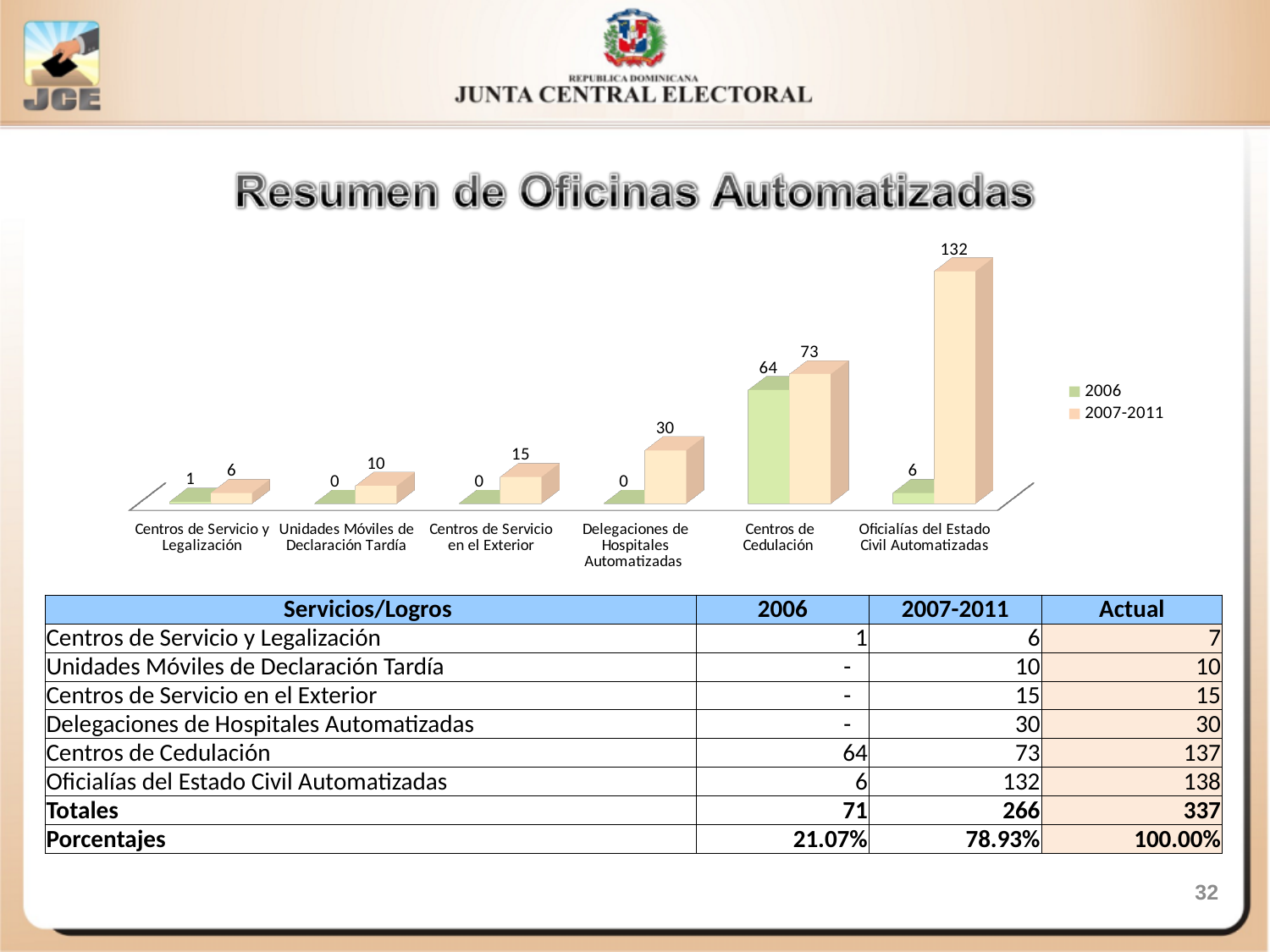
How many categories are shown on the x axis of the chart? 6 What is the difference between the 2007-2011 and 2006 values for Centros de Cedulación? 9 What is the 2006 value for Centros de Cedulación? 64 What kind of chart is shown on the slide? Bar chart What is the title of the chart? Resumen de Oficinas Automatizadas What are the two series named in the chart legend? 2006 and 2007-2011 What is the 2007-2011 value for Oficialías del Estado Civil Automatizadas? 132 How many series does the chart legend list? 2 Which category has the highest 2007-2011 value? Oficialías del Estado Civil Automatizadas Which category has the lowest 2007-2011 value? Centros de Servicio y Legalización What is the 2007-2011 value for Delegaciones de Hospitales Automatizadas? 30 Which is larger for Oficialías del Estado Civil Automatizadas: the 2006 value or the 2007-2011 value? 2007-2011